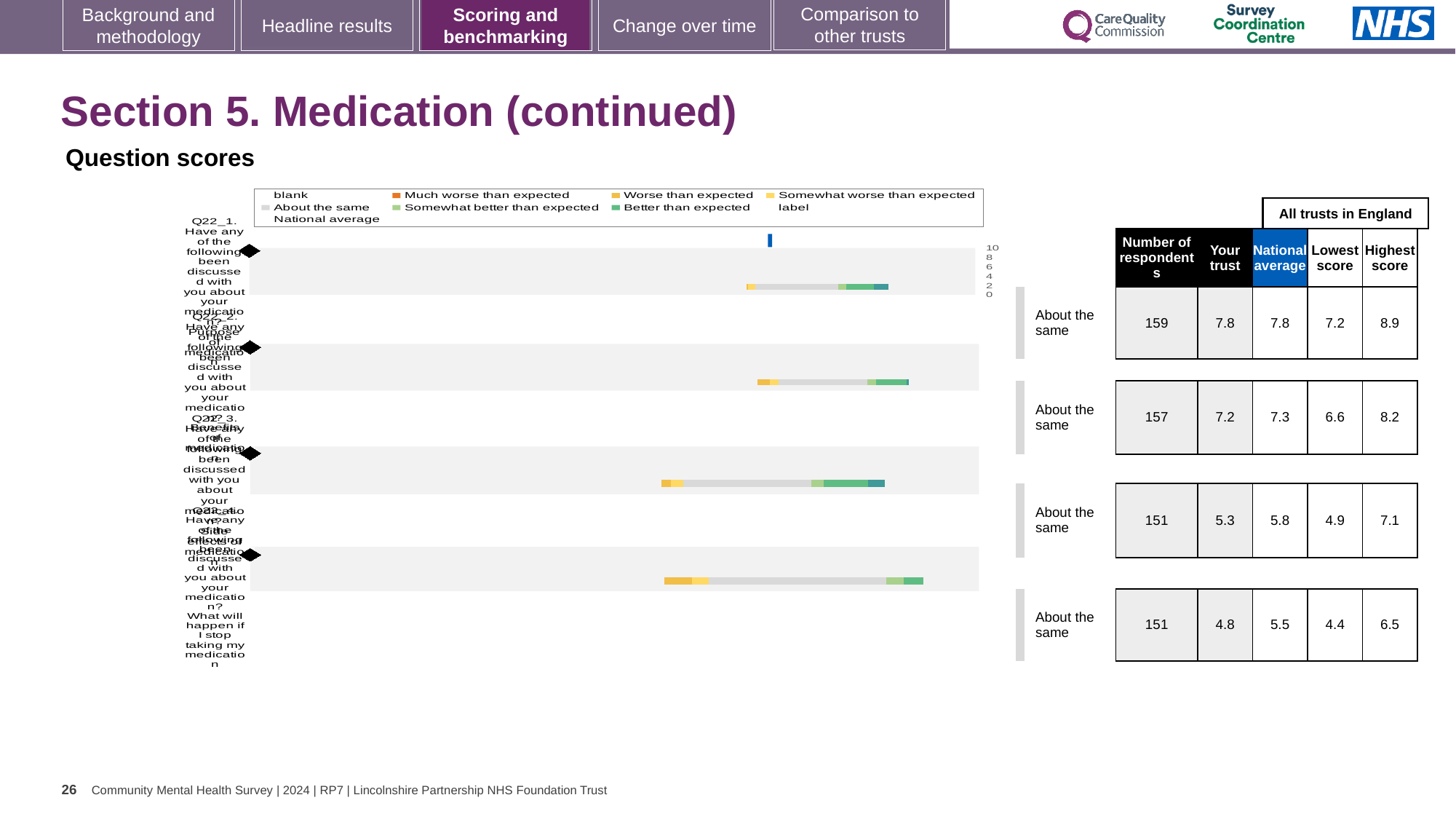
Which question row has the lowest 'Your trust' score? the fourth (bottom) row, with 4.8 How many question bars are plotted in the chart? 4 What is the national average score for the first (top) question, Q22_1? 7.8 For the fourth (bottom) question row, what is the difference between the national average and the 'Your trust' score? 0.7 For the third question row, which is larger: the 'Your trust' score or the national average? National average What is the lowest score listed for the second question row? 6.6 What benchmark label is shown next to each of the four question bars? About the same What kind of chart is shown on the slide? bar chart What is the maximum value shown on the chart's score axis? 10 What is the 'Your trust' score for the first (top) question, Q22_1? 7.8 How many respondents are listed for the third question row? 151 Which question row has the highest 'Highest score' value? the first (top) row, Q22_1, with 8.9